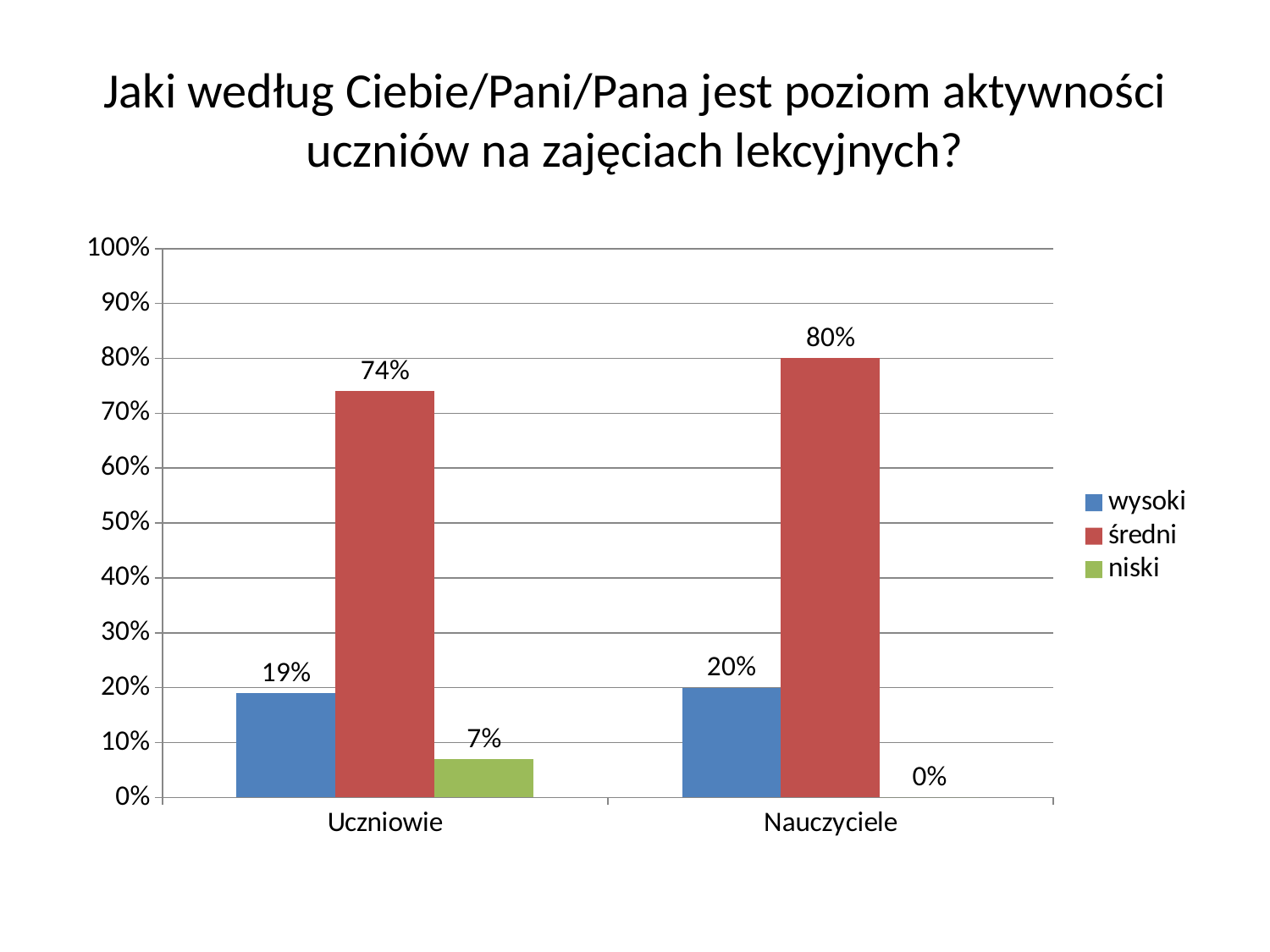
What kind of chart is shown on the slide? Bar chart Which series has the lowest value in the Uczniowie category? niski What is the value for "niski" in the Uczniowie category? 7% Which series has the highest value in the Nauczyciele category? średni What colour represents the "średni" series? Red How many series does the legend list? 3 What is the difference between the "średni" values for Nauczyciele and Uczniowie? 6% What is the value for "wysoki" in the Nauczyciele category? 20% Which is larger: the "wysoki" value for Uczniowie or for Nauczyciele? Nauczyciele How many categories are shown on the x axis? 2 What is the value for "niski" in the Nauczyciele category? 0% What is the value for "średni" in the Uczniowie category? 74%